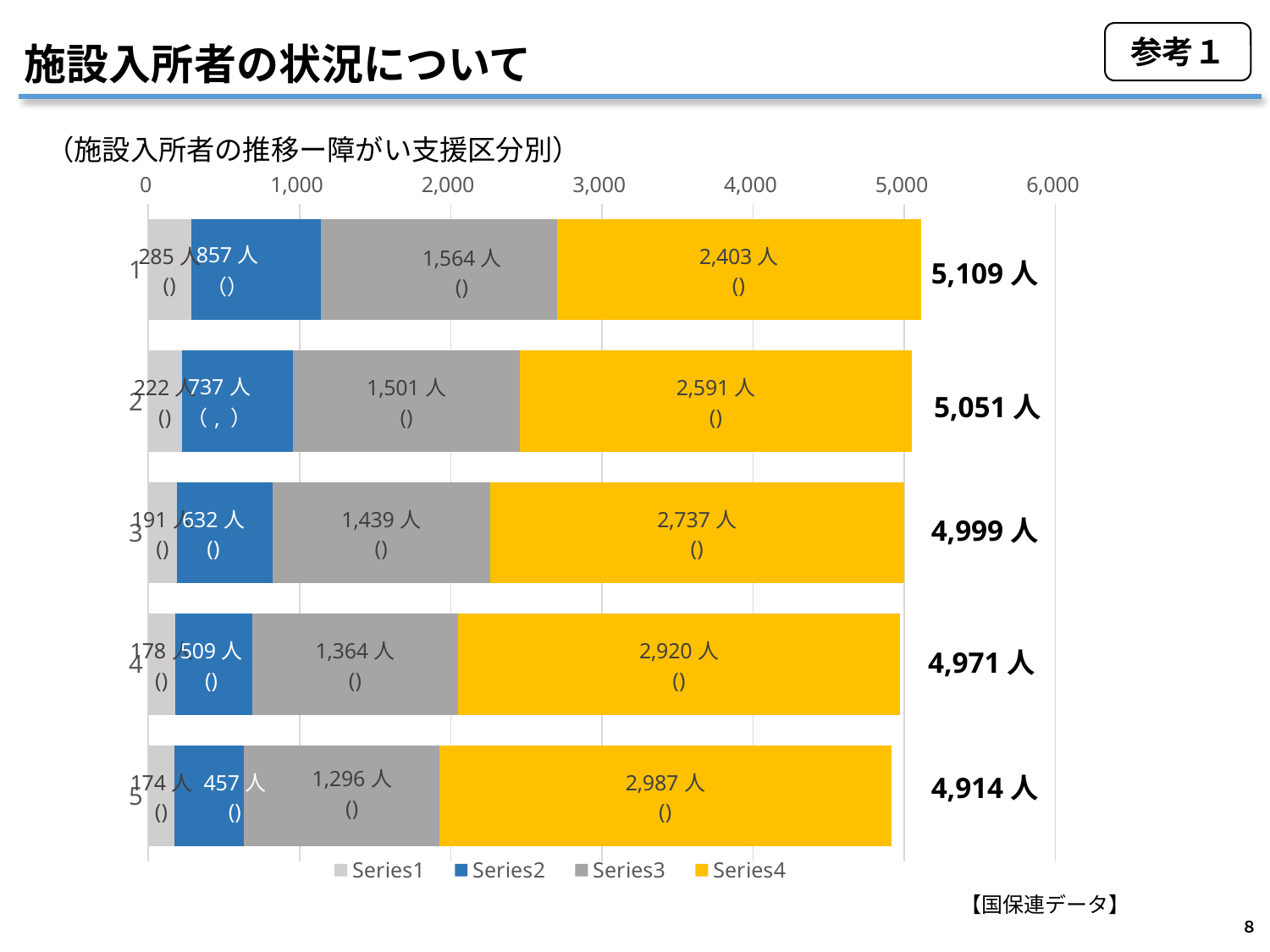
What is the value of Series2 for category 5? 457 人 Which category has the lowest Series4 value? 1 Do the Series4 values rise or fall from category 1 to category 5? Rise How many series does the legend list? 4 What is the value of Series4 for category 1? 2,403 人 What type of chart is shown on the slide? Stacked bar chart What is the difference between the Series4 values for category 5 and category 1? 584 人 What is the total shown for the category 3 bar? 4,999 人 How many categories are plotted on the chart? 5 Which category has the highest total? 1 Which is larger, the Series2 value for category 1 or for category 2? Category 1 What is the value of Series3 for category 4? 1,364 人